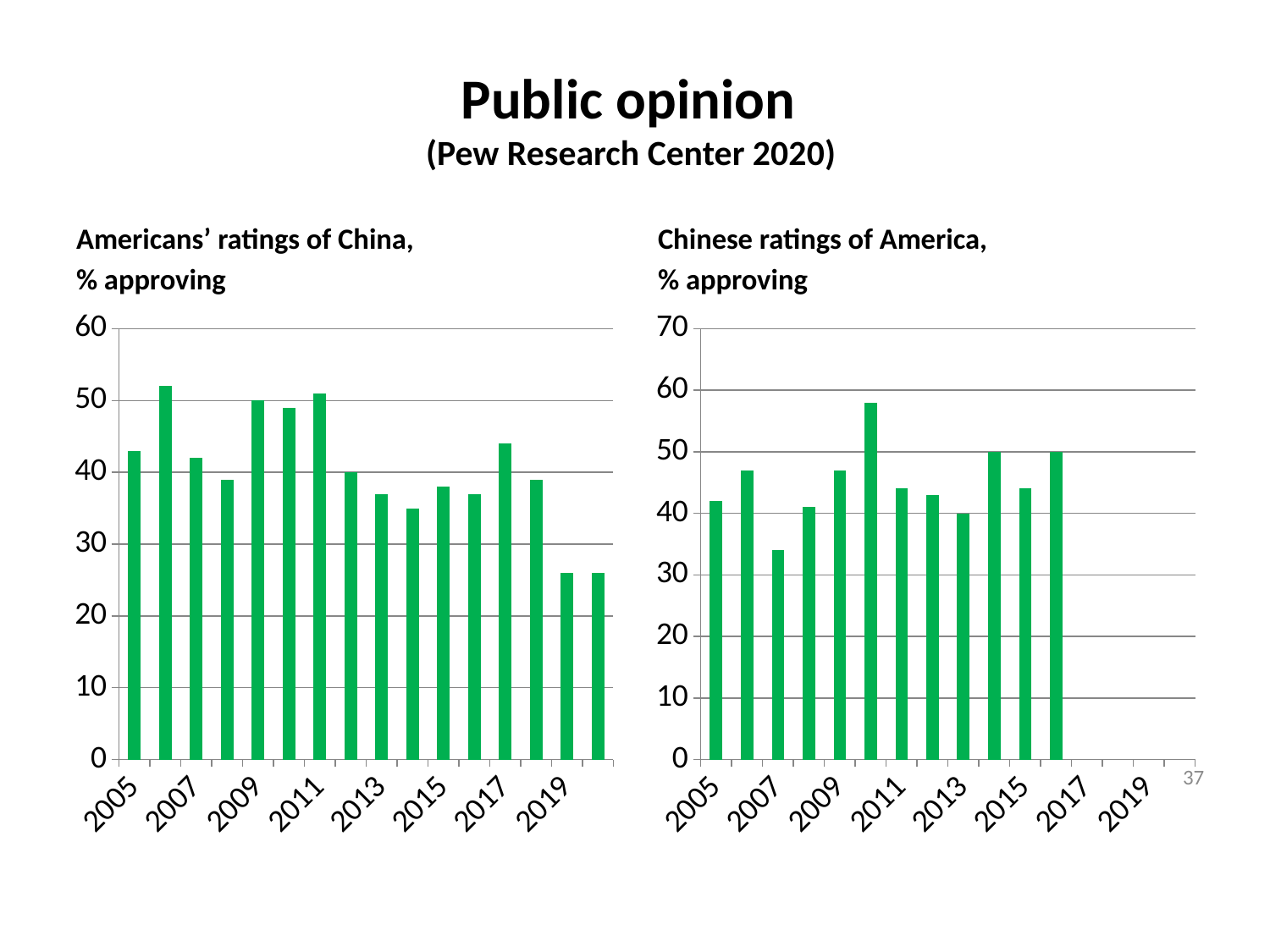
In the right chart, "Chinese ratings of America, % approving", how many bars (years) are plotted? 12 In the right chart, "Chinese ratings of America, % approving", which year has the lowest value? 2007 In the right chart, "Chinese ratings of America, % approving", is the value for 2010 greater or less than 50? greater In the right chart, "Chinese ratings of America, % approving", is the value for 2007 greater or less than 40? less In the left chart, "Americans' ratings of China, % approving", which year has the larger value, 2005 or 2019? 2005 In the left chart, "Americans' ratings of China, % approving", how many bars (years) are plotted? 16 What kind of chart is the left chart, "Americans' ratings of China, % approving"? bar chart In the left chart, "Americans' ratings of China, % approving", is the value for 2006 greater or less than 50? greater In the right chart, "Chinese ratings of America, % approving", which year has the larger value, 2007 or 2010? 2010 What is the title of the chart on the right side of the slide? Chinese ratings of America, % approving In the right chart, "Chinese ratings of America, % approving", which year has the highest value? 2010